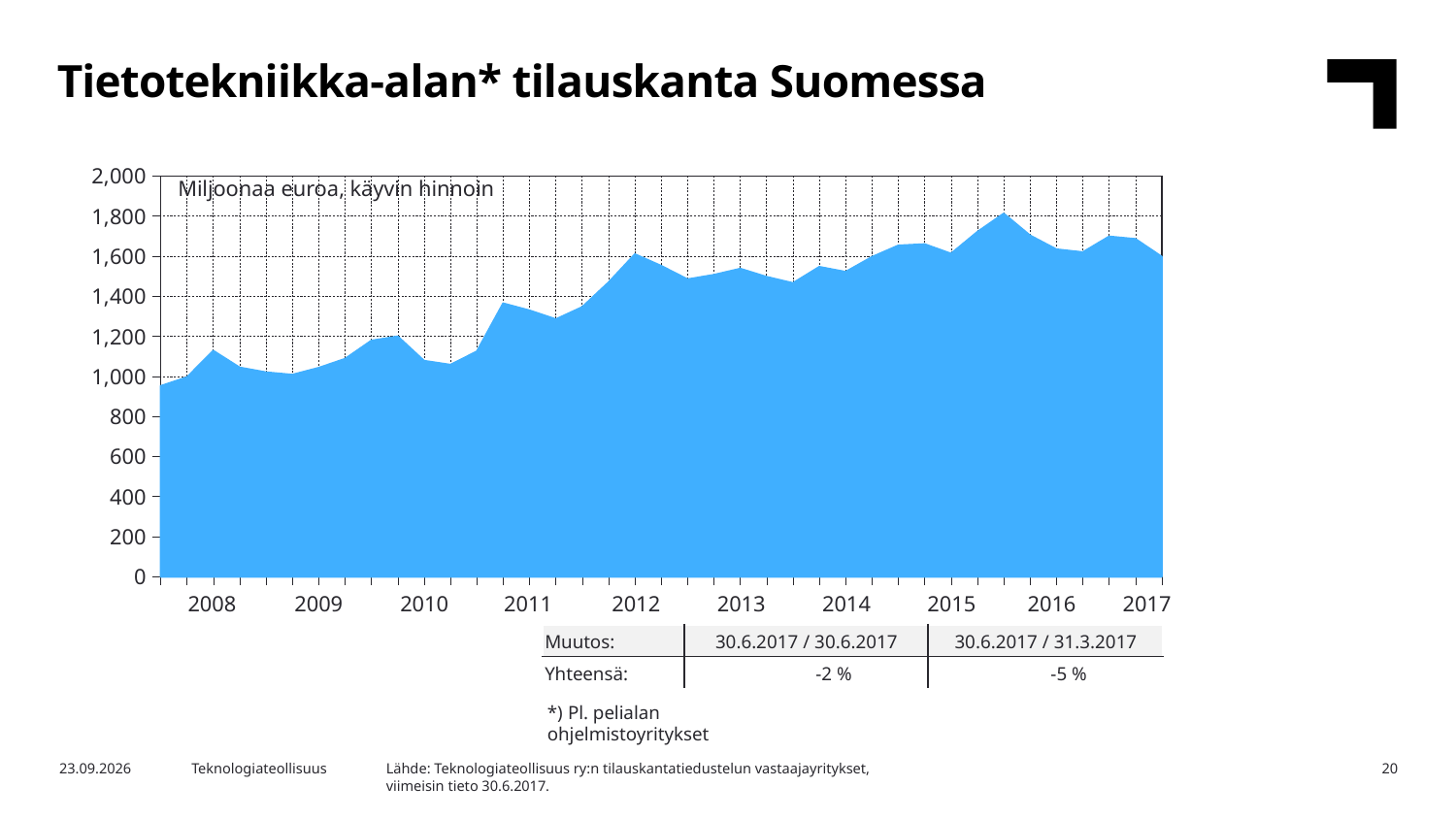
Which is larger, the value at 2010 or the value at 2014? 2014 Is the value at 2013 greater or less than 1,400? greater What is the title of the chart? Tietotekniikka-alan* tilauskanta Suomessa Which is larger, the value at 2008 or the value at 2017? 2017 What is the highest value shown on the y axis? 2,000 Is the highest point of the chart greater or less than 1,600? greater Is the value at the start of 2008 greater or less than 1,200? less How many years are labelled on the x axis? 10 Overall, do the values rise or fall from 2008 to 2017? rise What unit is stated inside the chart area? Miljoonaa euroa, käyvin hinnoin What kind of chart is shown on the slide? area chart